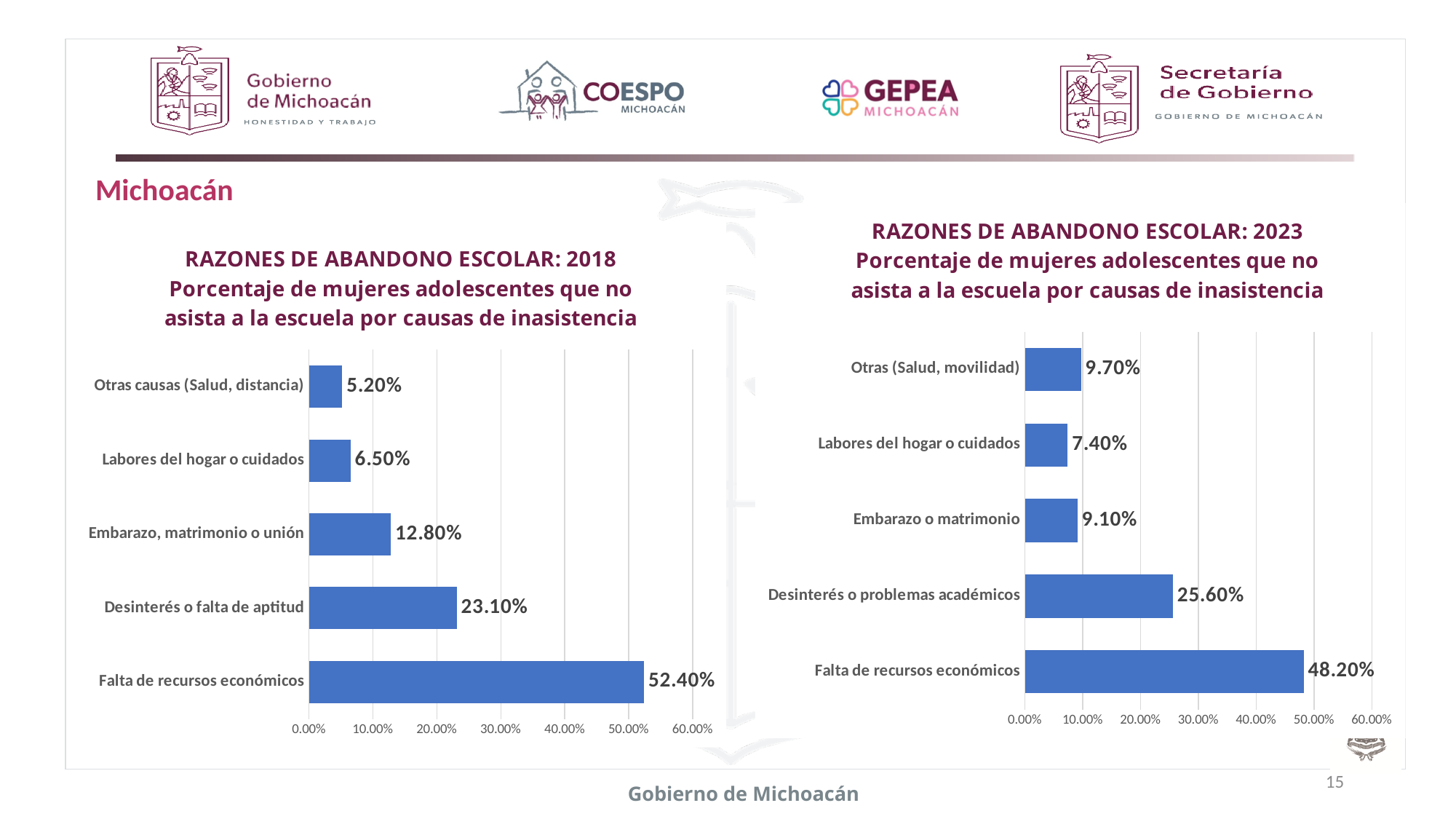
How many categories are shown in the 2018 chart? 5 In the 2018 chart (RAZONES DE ABANDONO ESCOLAR: 2018), what is the value for Falta de recursos económicos? 52.40% In the 2023 chart, which category has the highest value? Falta de recursos económicos In the 2018 chart, what is the value for Labores del hogar o cuidados? 6.50% In the 2018 chart, which category has the lowest value? Otras causas (Salud, distancia) In the 2018 chart, which is larger: Embarazo, matrimonio o unión or Labores del hogar o cuidados? Embarazo, matrimonio o unión In the 2023 chart (RAZONES DE ABANDONO ESCOLAR: 2023), what is the value for Desinterés o problemas académicos? 25.60% In the 2018 chart, what is the difference between Falta de recursos económicos and Desinterés o falta de aptitud? 29.30% In the 2023 chart, which category has the lowest value? Labores del hogar o cuidados In the 2023 chart, is the value for Falta de recursos económicos greater or less than 50.00%? less In the 2023 chart, what is the difference between Otras (Salud, movilidad) and Embarazo o matrimonio? 0.60% What kind of chart is the 2023 chart (RAZONES DE ABANDONO ESCOLAR: 2023)? Bar chart